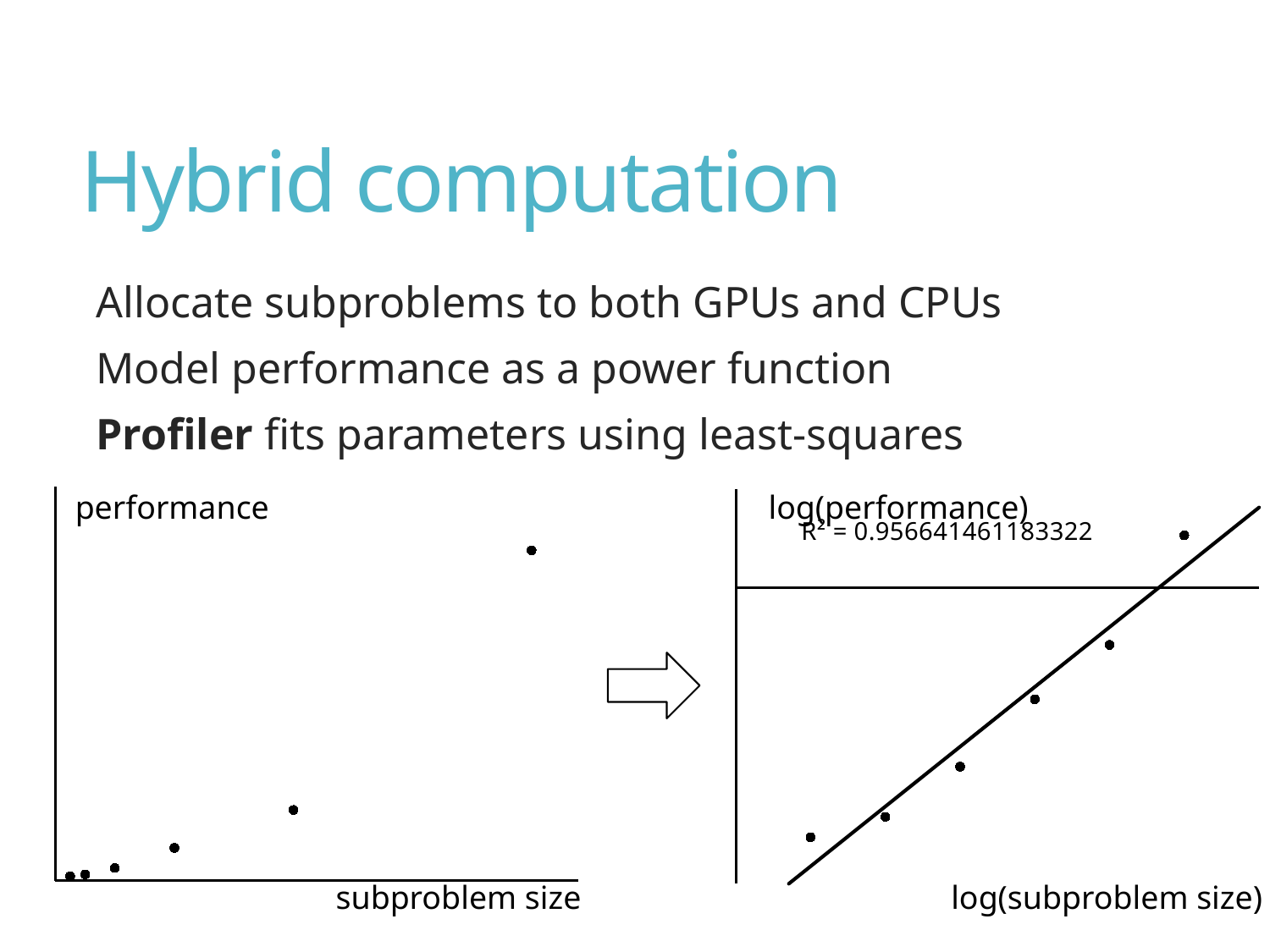
What kind of chart is the left chart on the slide? scatter chart What is the R² value shown on the right chart? 0.956641461183322 What is the x-axis label of the left chart? subproblem size How many data points are plotted in the left chart (performance vs subproblem size)? 6 What kind of chart is the right chart on the slide? scatter chart In the left chart, which point has the higher performance: the rightmost point or the leftmost point? the rightmost point In the right chart, do the log(performance) values rise or fall along the x axis? rise In the left chart, do the performance values rise or fall as subproblem size increases? rise In the right chart, which point has the lower log(performance): the leftmost point or the rightmost point? the leftmost point How many data points are plotted in the right chart (log(performance) vs log(subproblem size))? 6